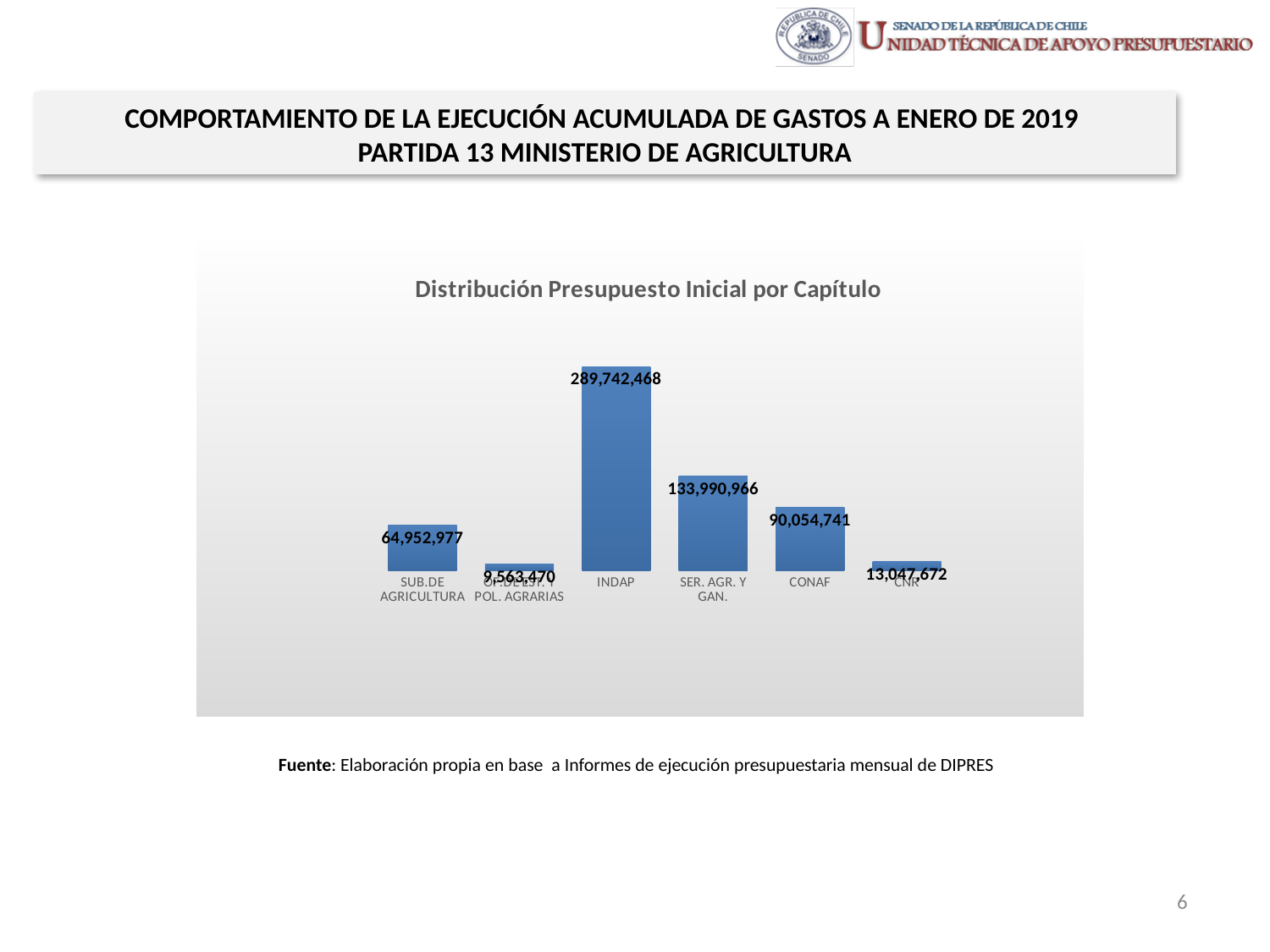
What is the value for CNR? 13,047,672 What is the value for INDAP? 289,742,468 Which category has the highest value? INDAP What is the value for SUB.DE AGRICULTURA? 64,952,977 What is the difference between the values for INDAP and SER. AGR. Y GAN.? 155,751,502 What is the difference between the values for CONAF and SUB.DE AGRICULTURA? 25,101,764 How many categories are shown in the chart? 6 What is the title of the chart? Distribución Presupuesto Inicial por Capítulo What is the value for SER. AGR. Y GAN.? 133,990,966 Which is larger, the value for CONAF or the value for SUB.DE AGRICULTURA? CONAF What is the value for CONAF? 90,054,741 What is the lowest value shown in the chart? 9,563,470